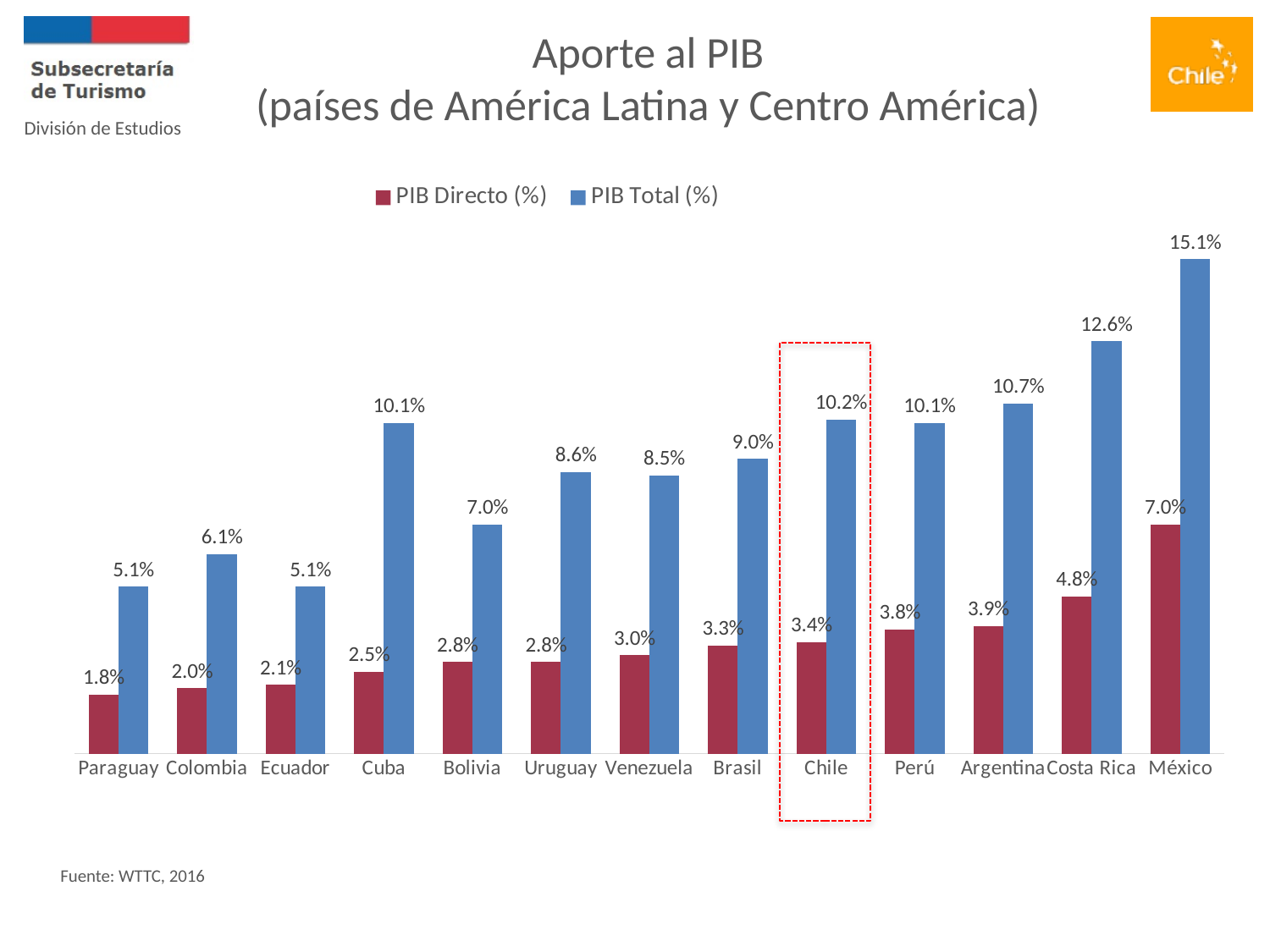
Do the PIB Directo (%) values rise or fall from Paraguay to México along the x axis? Rise What is the PIB Total (%) value for Cuba? 10.1% How many series does the legend list? 2 What kind of chart is shown on the slide? Bar chart What is the difference between the PIB Total (%) of México and Costa Rica? 2.5% Which has a larger PIB Total (%), Uruguay or Venezuela? Uruguay What is the PIB Directo (%) value for Paraguay? 1.8% Which country has the highest PIB Total (%)? México How many countries are shown on the x axis? 13 What is the PIB Total (%) value for Chile? 10.2% Which country has the lowest PIB Directo (%)? Paraguay Which country is highlighted with a red dashed box on the chart? Chile